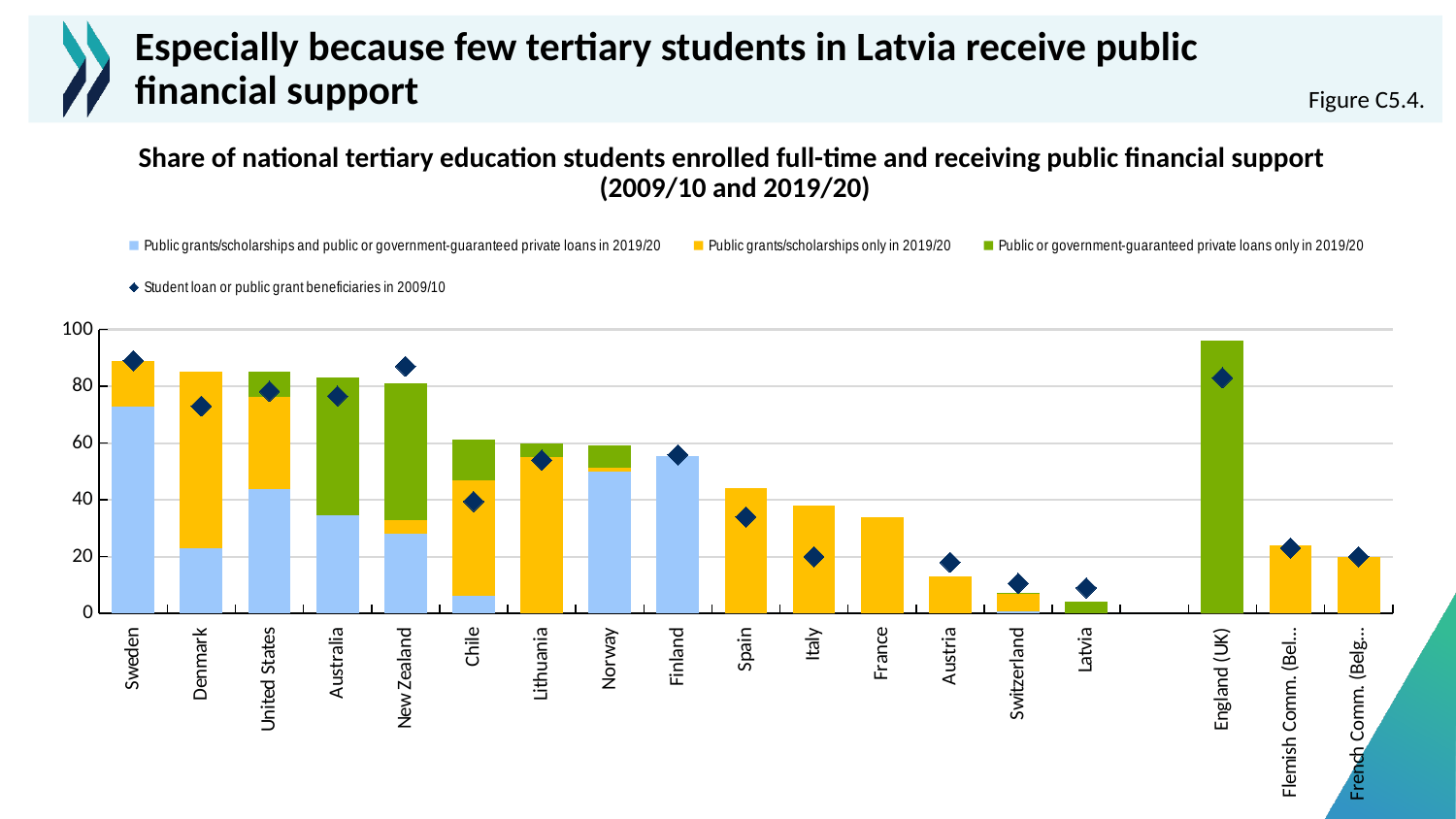
What kind of chart is shown on the slide? Bar chart Which has the taller stacked bar, England (UK) or Sweden? England (UK) Is the total bar value for France greater or less than 40? less Which has the taller stacked bar, Austria or Latvia? Austria What figure number is given for the chart on the slide? Figure C5.4. How many series does the chart's legend list? 4 Which country has the shortest stacked bar in the chart? Latvia Is the total bar value for Chile greater or less than 40? greater Which country or region has the tallest stacked bar in the chart? England (UK) Is the total bar value for Sweden greater or less than 80? greater How many countries or regions are shown along the x axis of the chart? 18